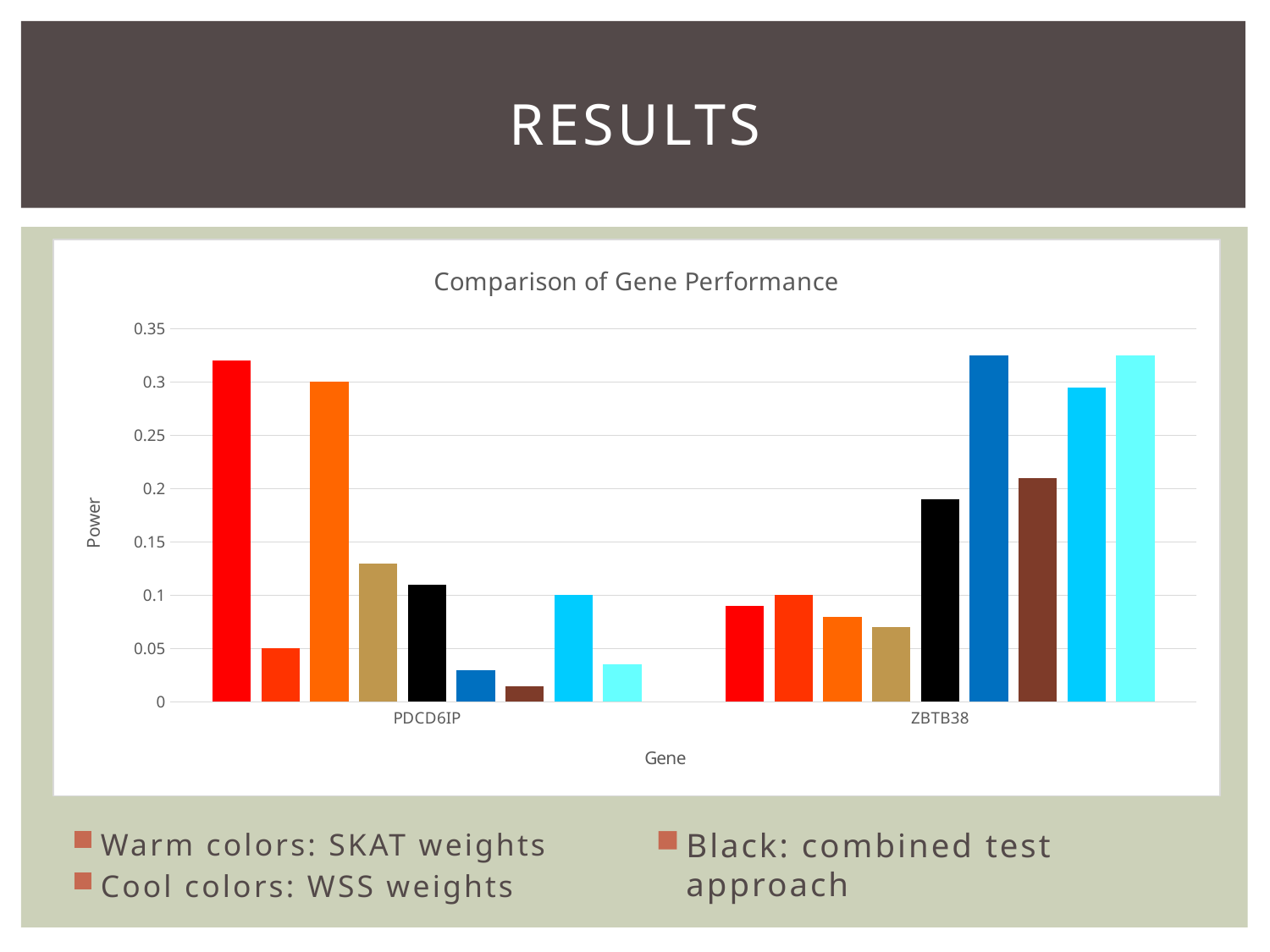
Is the value of the red (leftmost) bar for PDCD6IP greater or less than 0.3? greater Which gene has the larger value for the black bar, PDCD6IP or ZBTB38? ZBTB38 Is the value of the black bar for ZBTB38 greater or less than 0.15? greater How many genes (categories) are shown on the x axis? 2 Which gene has the larger value for the red (leftmost) bar, PDCD6IP or ZBTB38? PDCD6IP What is the label of the y axis? Power Is the value of the black bar for PDCD6IP greater or less than 0.15? less What type of chart is shown on the slide? bar chart What is the title of the chart? Comparison of Gene Performance How many bars are plotted for the gene PDCD6IP? 9